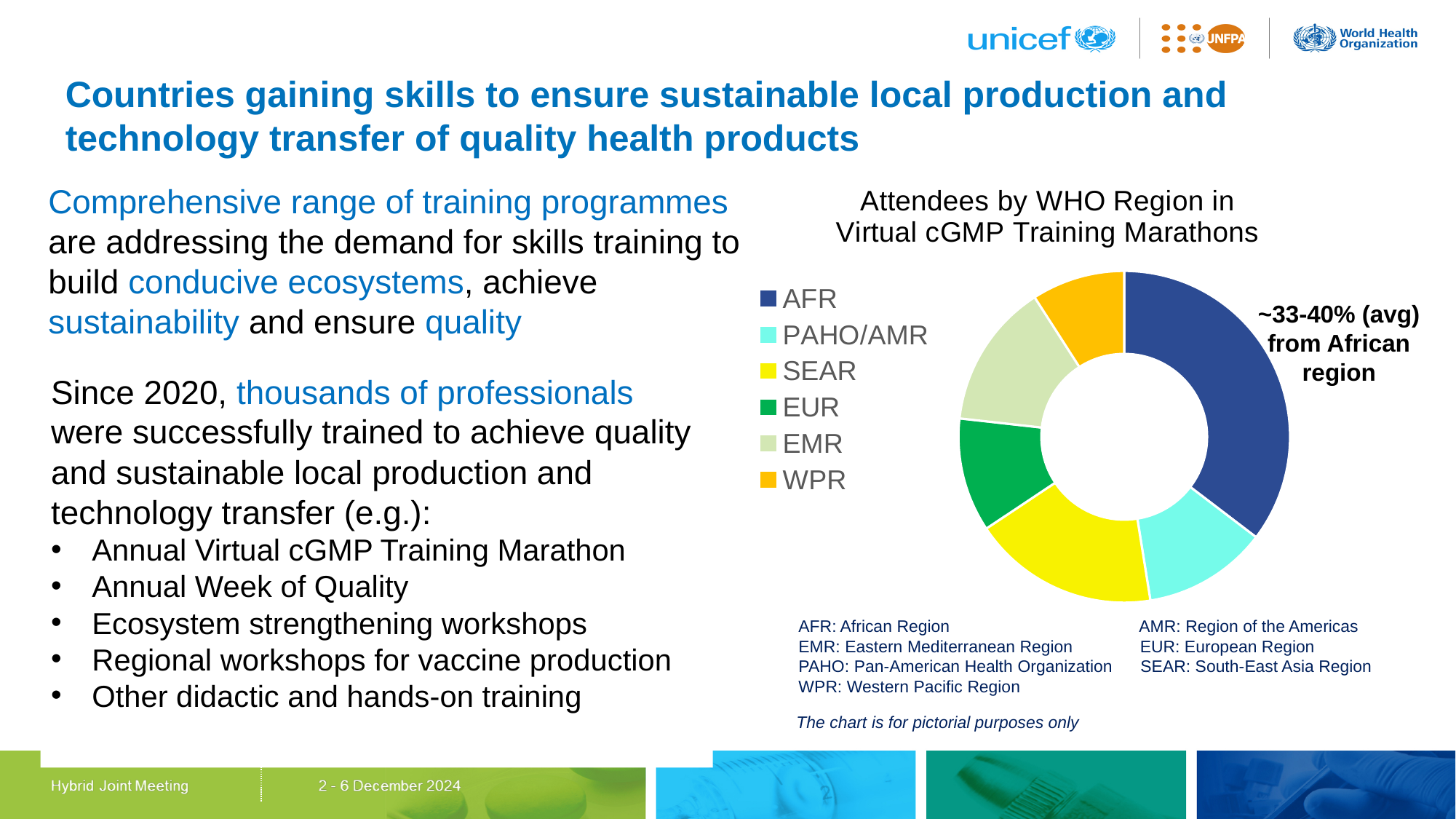
Which has a larger share of attendees, AFR or EMR? AFR What is the title of the chart? Attendees by WHO Region in Virtual cGMP Training Marathons Which has a larger share of attendees, EMR or WPR? EMR What kind of chart is shown on the slide? doughnut (pie) chart Which has a larger share of attendees, AFR or SEAR? AFR What annotation is printed next to the AFR slice of the chart? ~33-40% (avg) from African region How many WHO regions are shown in the chart? 6 Which region has the largest share of attendees in the chart? AFR